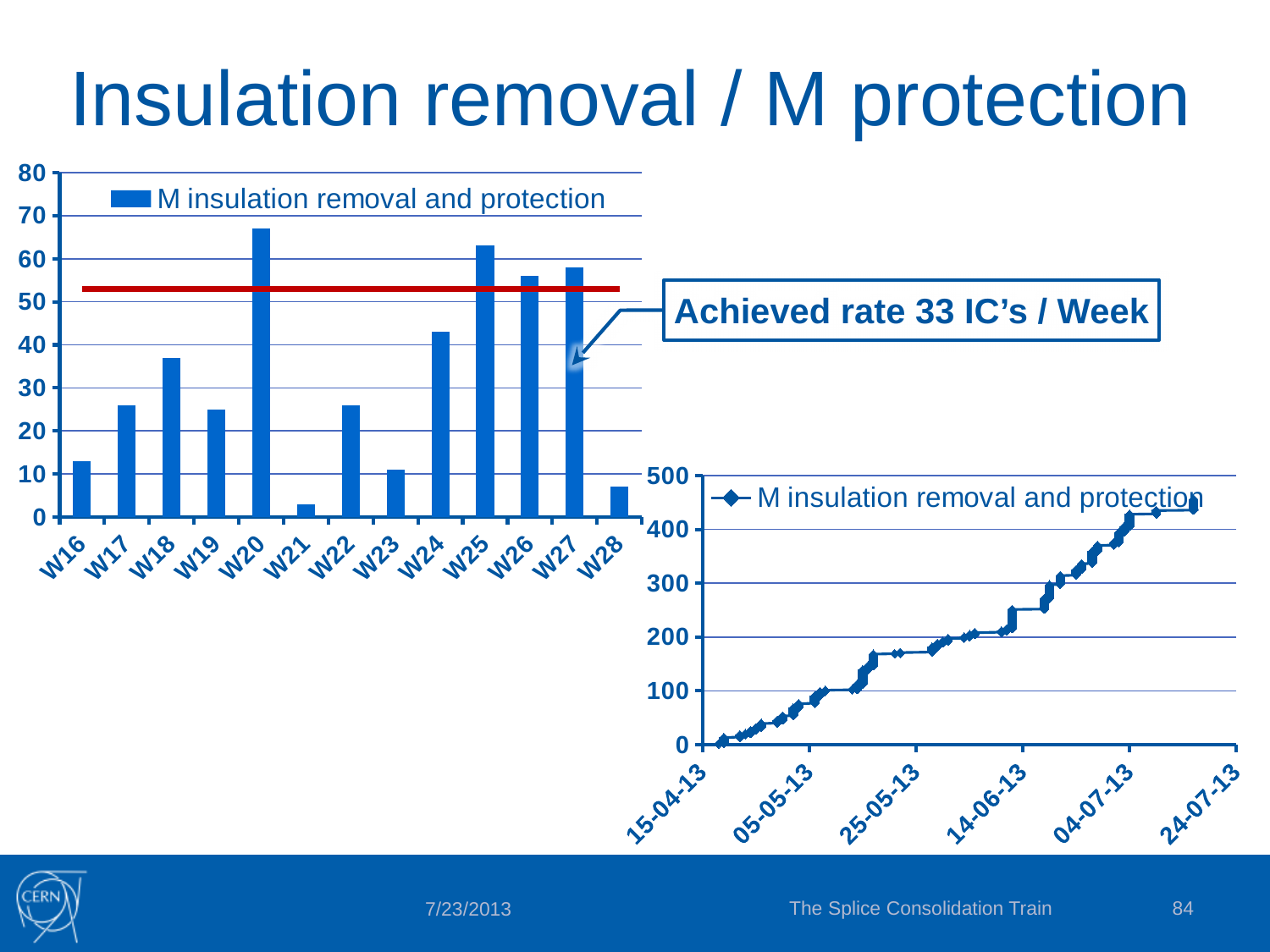
In the bar chart on the left, which week has the highest value? W20 In the line chart on the lower right, do the values rise or fall from 15-04-13 to 24-07-13? rise What kind of chart is the chart on the lower right? line chart In the bar chart on the left, which is larger, the value for W18 or the value for W23? W18 In the bar chart on the left, is the value for W16 greater or less than 20? less What kind of chart is the chart on the left? bar chart In the bar chart on the left, which is larger, the value for W25 or the value for W28? W25 In the bar chart on the left, which week has the lowest value? W21 In the bar chart on the left, is the value for W20 greater or less than 60? greater In the line chart on the lower right, is the last plotted value greater or less than 400? greater In the bar chart on the left, how many weeks are shown on the x axis? 13